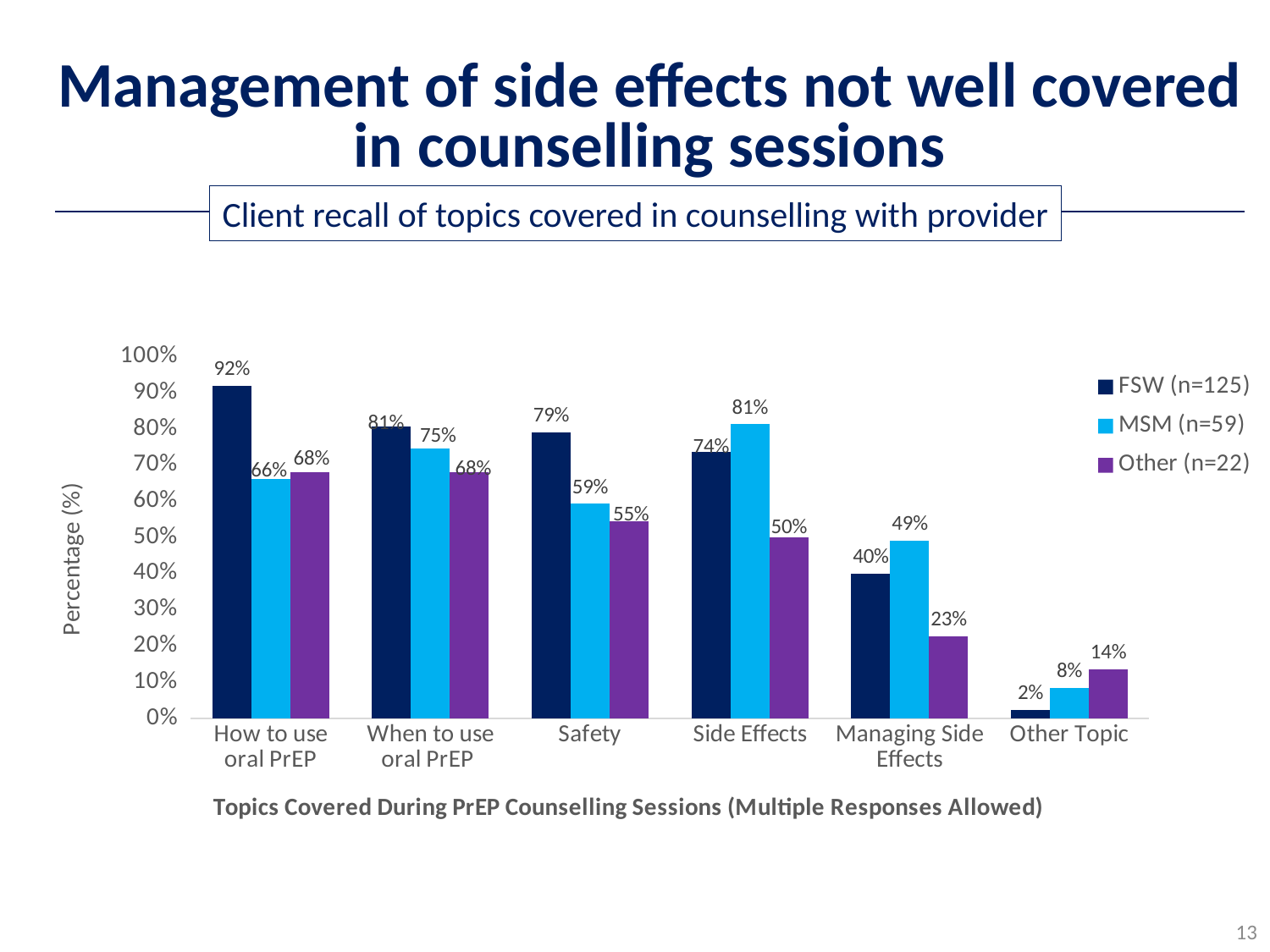
What percentage of FSW clients recalled 'How to use oral PrEP' being covered? 92% What is the value for Other (n=22) for 'Managing Side Effects'? 23% For 'Managing Side Effects', which group has the larger value, FSW or MSM? MSM Which topic has the lowest value for FSW (n=125)? Other Topic How many topic categories are shown on the x axis? 6 Which topic has the highest value for MSM (n=59)? Side Effects What kind of chart is shown on the slide? Bar chart What is the sample size for the FSW group shown in the legend? n=125 What is the value for MSM (n=59) for 'Side Effects'? 81% What is the label of the y axis? Percentage (%) What is the difference between the FSW and MSM values for 'Safety'? 20 percentage points How many series does the legend list? 3